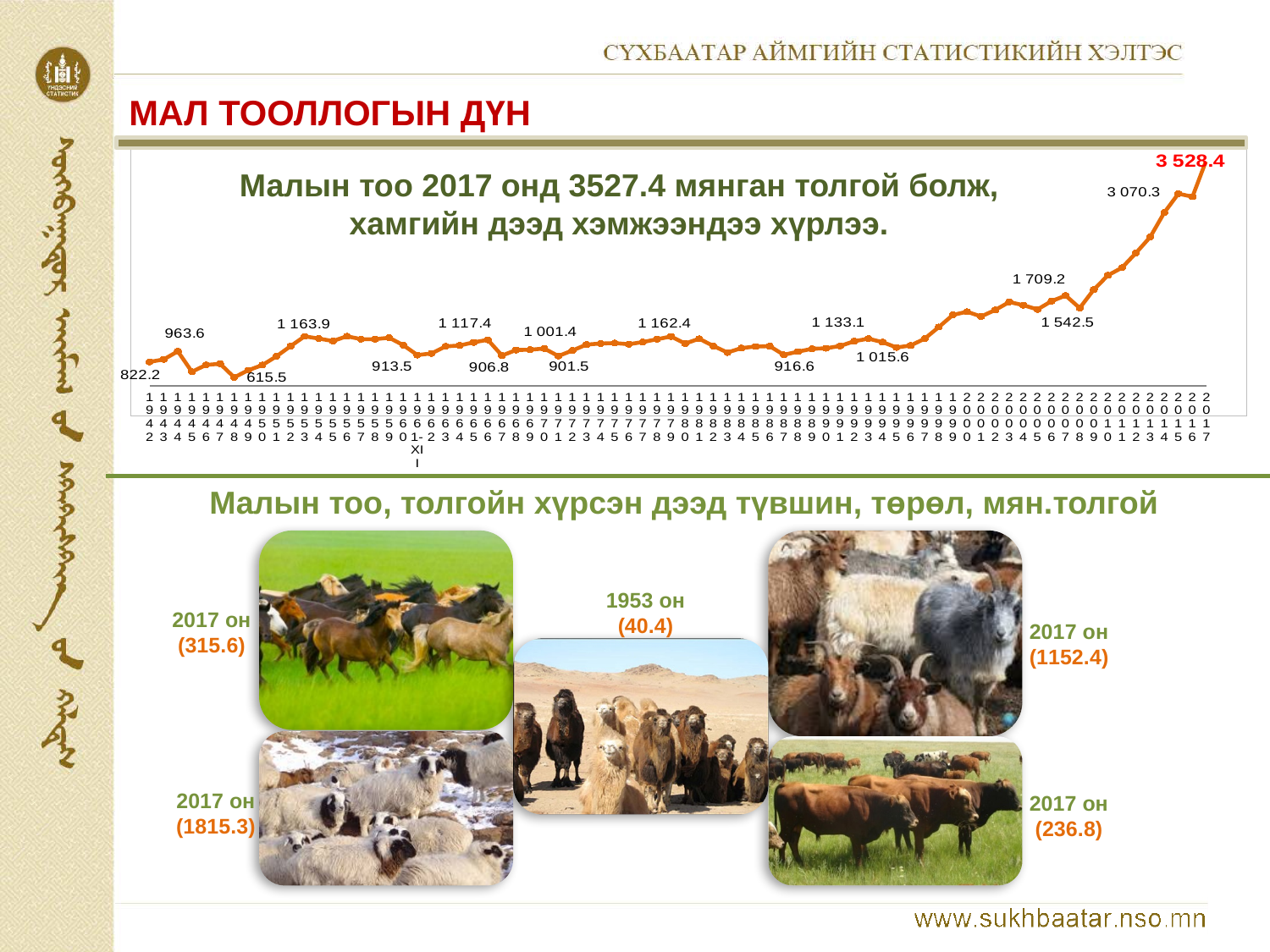
How many data series are plotted on the line chart? 1 What is the difference between the 2017 value (3 528.4) and the 1942 value (822.2)? 2 706.2 Overall, does the line rise or fall from 1942 to 2017? rise Which labelled value is larger: 1 709.2 or 1 542.5? 1 709.2 What kind of chart is shown on the slide? line chart What is the highest value labelled on the line chart? 3 528.4 Which labelled value is larger: 1 163.9 or 1 117.4? 1 163.9 What is the value of the last point on the line chart, for 2017? 3 528.4 What is the second-highest value labelled on the line chart? 3 070.3 What is the value of the first point on the line chart, for 1942? 822.2 What is the lowest value labelled on the line chart? 615.5 What is the difference between the highest labelled value (3 528.4) and the second-highest (3 070.3)? 458.1